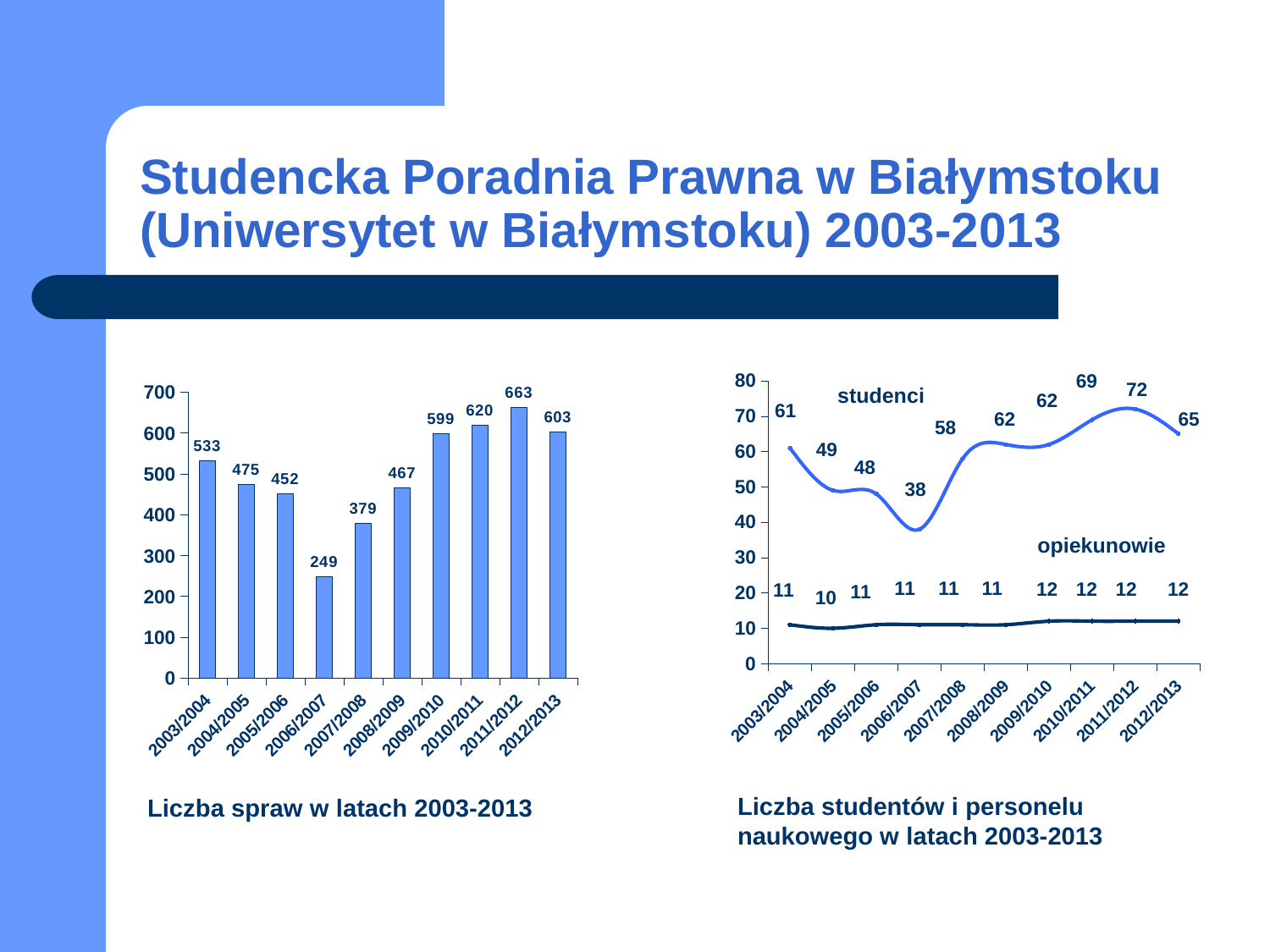
In the left chart (Liczba spraw w latach 2003-2013), which year has the highest value? 2011/2012 In the left chart (Liczba spraw w latach 2003-2013), what is the difference between the values for 2011/2012 and 2012/2013? 60 In the left chart (Liczba spraw w latach 2003-2013), which year has the lowest value? 2006/2007 In the left chart (Liczba spraw w latach 2003-2013), which is larger: the value for 2004/2005 or 2008/2009? 2004/2005 In the right chart (Liczba studentów i personelu naukowego), what is the difference between studenci and opiekunowie in 2012/2013? 53 In the right chart (Liczba studentów i personelu naukowego), what is the value for studenci in 2006/2007? 38 In the left chart (Liczba spraw w latach 2003-2013), what is the value for 2006/2007? 249 In the left chart (Liczba spraw w latach 2003-2013), how many years are shown on the x axis? 10 In the right chart (Liczba studentów i personelu naukowego), how many series are plotted? 2 What kind of chart is the left chart (Liczba spraw w latach 2003-2013)? Bar chart In the right chart (Liczba studentów i personelu naukowego), in which year is the studenci value highest? 2011/2012 In the right chart (Liczba studentów i personelu naukowego), what is the value for opiekunowie in 2004/2005? 10